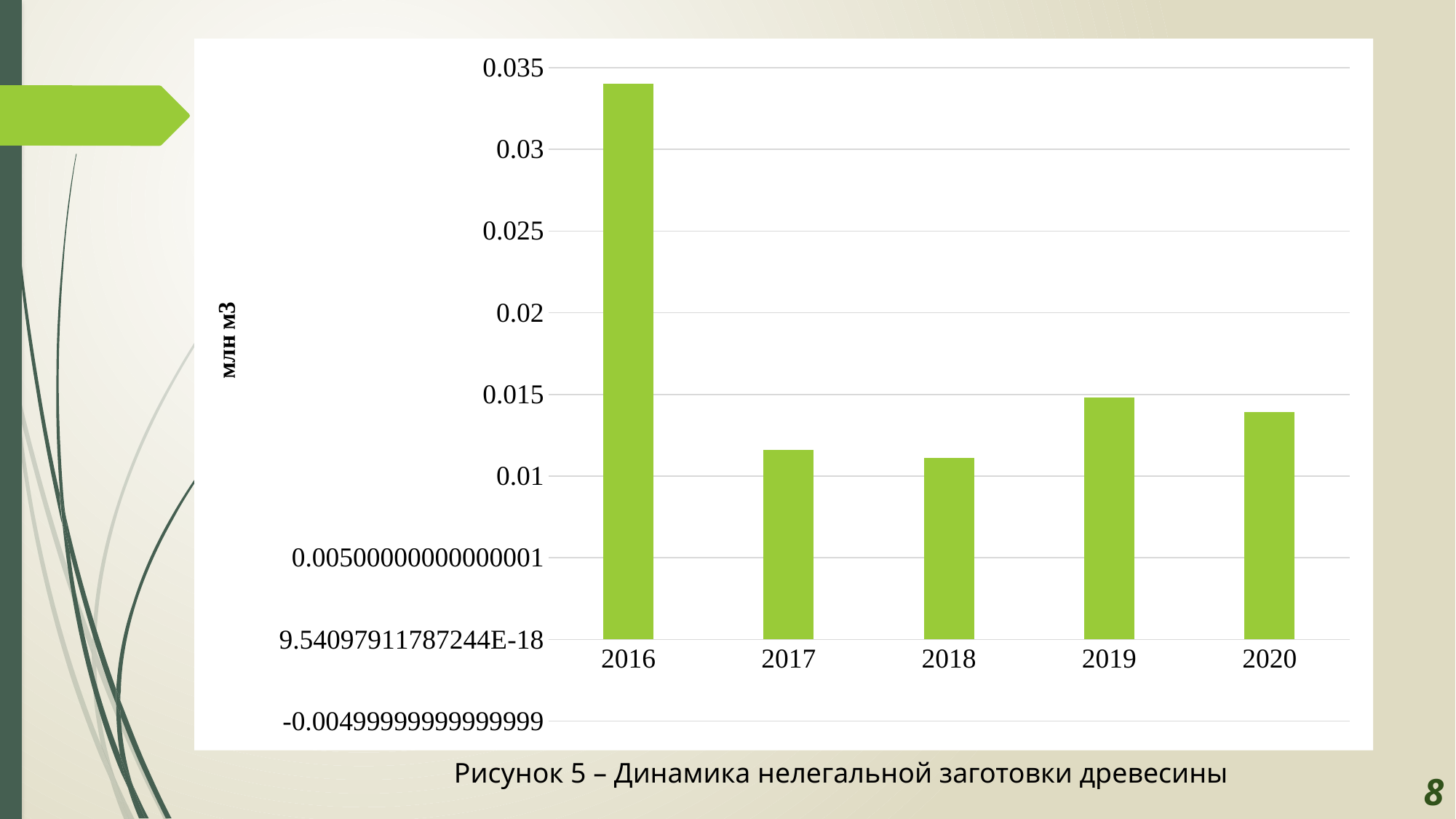
What is the label on the vertical axis of the chart? млн м3 Which year has the highest bar in the chart? 2016 How many years are shown on the x axis of the chart? 5 Is the value for 2016 greater or less than 0.03? greater Is the value for 2017 greater or less than 0.01? greater What is the caption printed below the chart? Рисунок 5 – Динамика нелегальной заготовки древесины What kind of chart is shown on the slide? bar chart Is the value for 2018 greater or less than 0.015? less Which is larger, the value for 2016 or the value for 2019? 2016 Does the value rise or fall from 2016 to 2017? fall